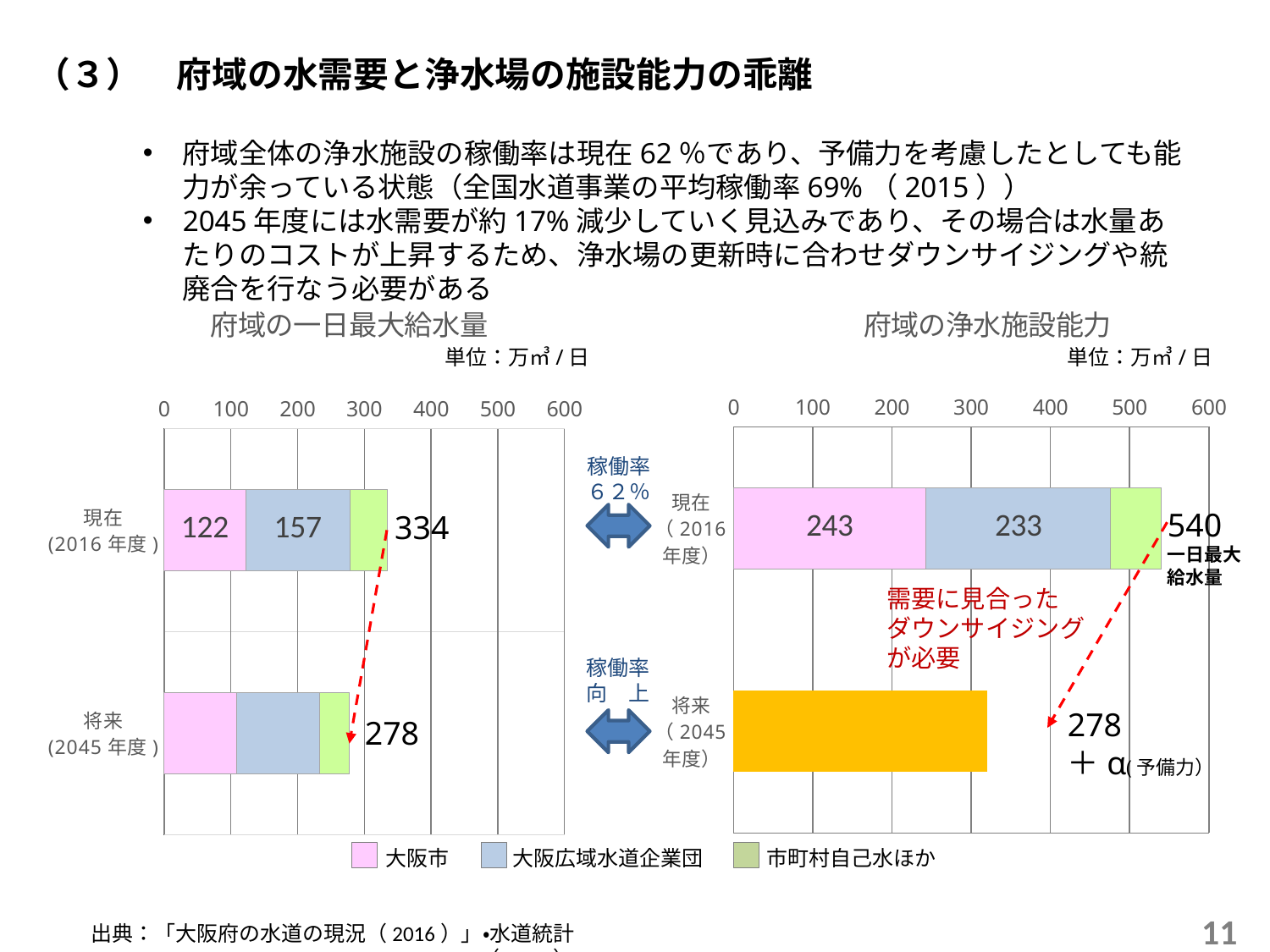
In the 府域の一日最大給水量 chart (left), what is the value for 大阪市 in 現在 (2016年度)? 122 How many series does the shared legend below the charts list? 3 In the 府域の一日最大給水量 chart (left), which is larger in 現在 (2016年度): 大阪市 or 大阪広域水道企業団? 大阪広域水道企業団 In the 府域の浄水施設能力 chart (right), what is the value for 大阪広域水道企業団 in 現在 (2016年度)? 233 In the 府域の一日最大給水量 chart (left), what is the total of the 将来 (2045年度) bar? 278 In the 府域の一日最大給水量 chart (left), what is the value for 大阪広域水道企業団 in 現在 (2016年度)? 157 In the 府域の浄水施設能力 chart (right), what is the difference between the 大阪市 and 大阪広域水道企業団 values in 現在 (2016年度)? 10 In the 府域の浄水施設能力 chart (right), what is the total of the 現在 (2016年度) bar? 540 What kind of chart is the 府域の浄水施設能力 chart (right)? Stacked bar chart In the 府域の一日最大給水量 chart (left), by how much does the total fall from 現在 (2016年度) to 将来 (2045年度)? 56 In the 府域の一日最大給水量 chart (left), what is the total of the 現在 (2016年度) bar? 334 In the 府域の浄水施設能力 chart (right), what is the value for 大阪市 in 現在 (2016年度)? 243